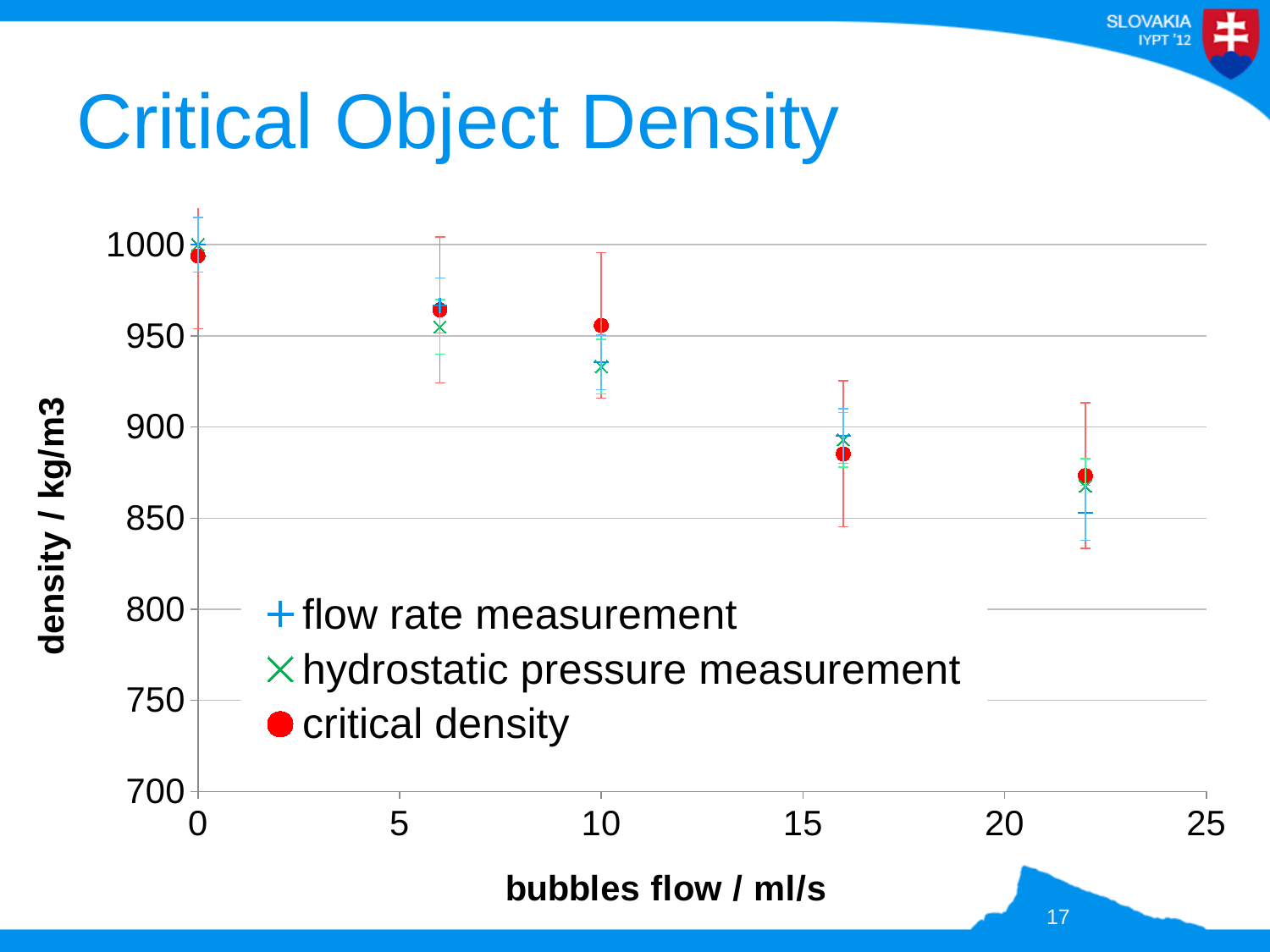
Is the hydrostatic pressure measurement at a bubbles flow of 22 ml/s greater or less than 900 kg/m3? less What is the title of the chart? Critical Object Density Is the critical density at a bubbles flow of 22 ml/s greater or less than 900 kg/m3? less What is the label of the x axis? bubbles flow / ml/s Does the critical density rise or fall as bubbles flow increases? fall Is the critical density at a bubbles flow of 0 ml/s greater or less than 950 kg/m3? greater How many series does the legend list? 3 Which is larger, the critical density at a bubbles flow of 0 ml/s or at 22 ml/s? 0 ml/s How many data points does the critical density series have? 5 What kind of chart is shown on the slide? scatter chart